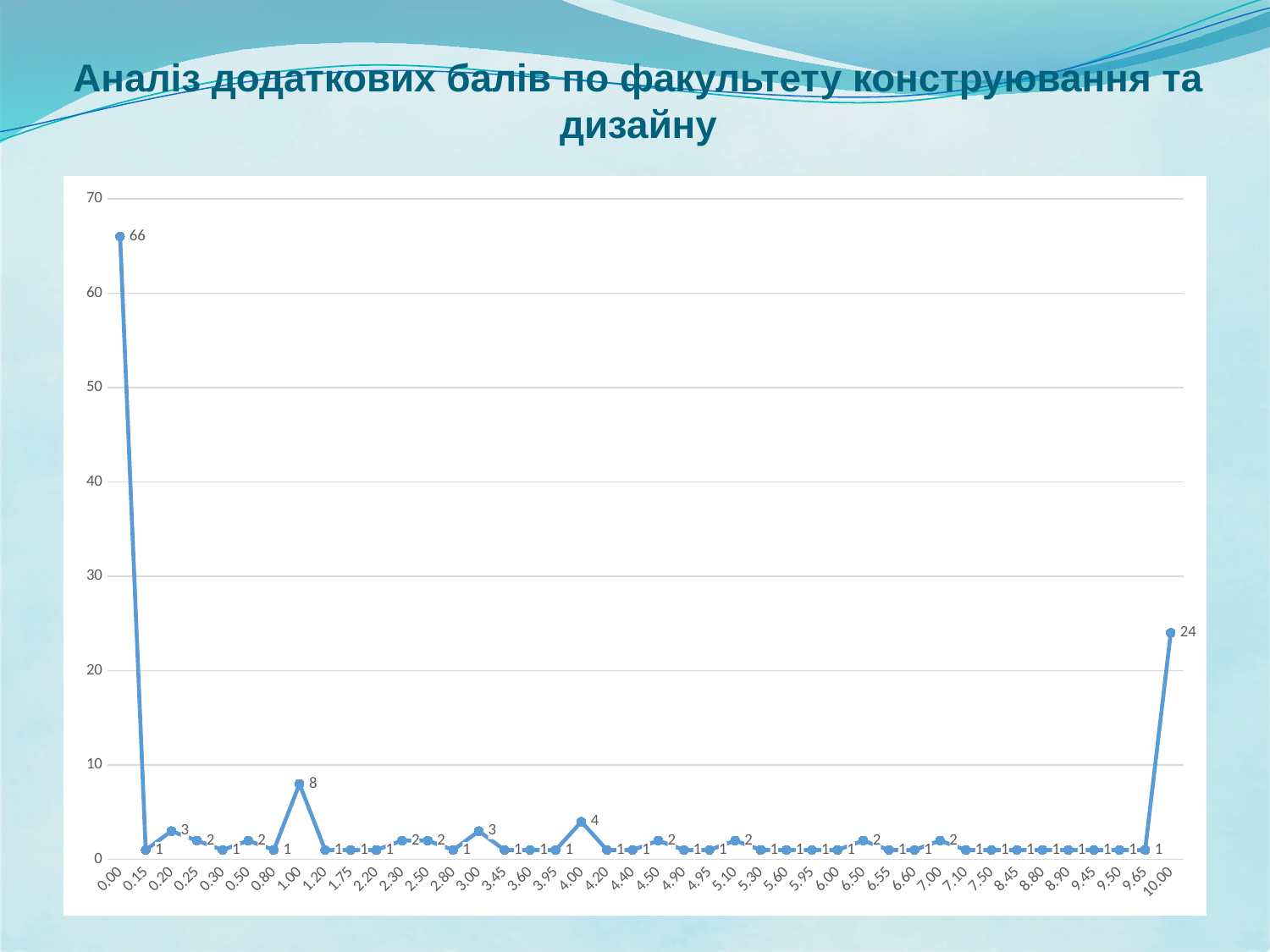
What is the title of the slide? Аналіз додаткових балів по факультету конструювання та дизайну Is the value at 0.00 greater or less than 60? greater How many data points are plotted on the chart? 42 What is the value at category 0.00? 66 What is the value at category 3.00? 3 What is the value at category 1.00? 8 What is the value at category 4.00? 4 What is the value at category 10.00? 24 What is the difference between the values at 0.00 and 10.00? 42 Which is larger, the value at 1.00 or the value at 10.00? 10.00 Which category has the highest value? 0.00 What type of chart is shown on the slide? line chart